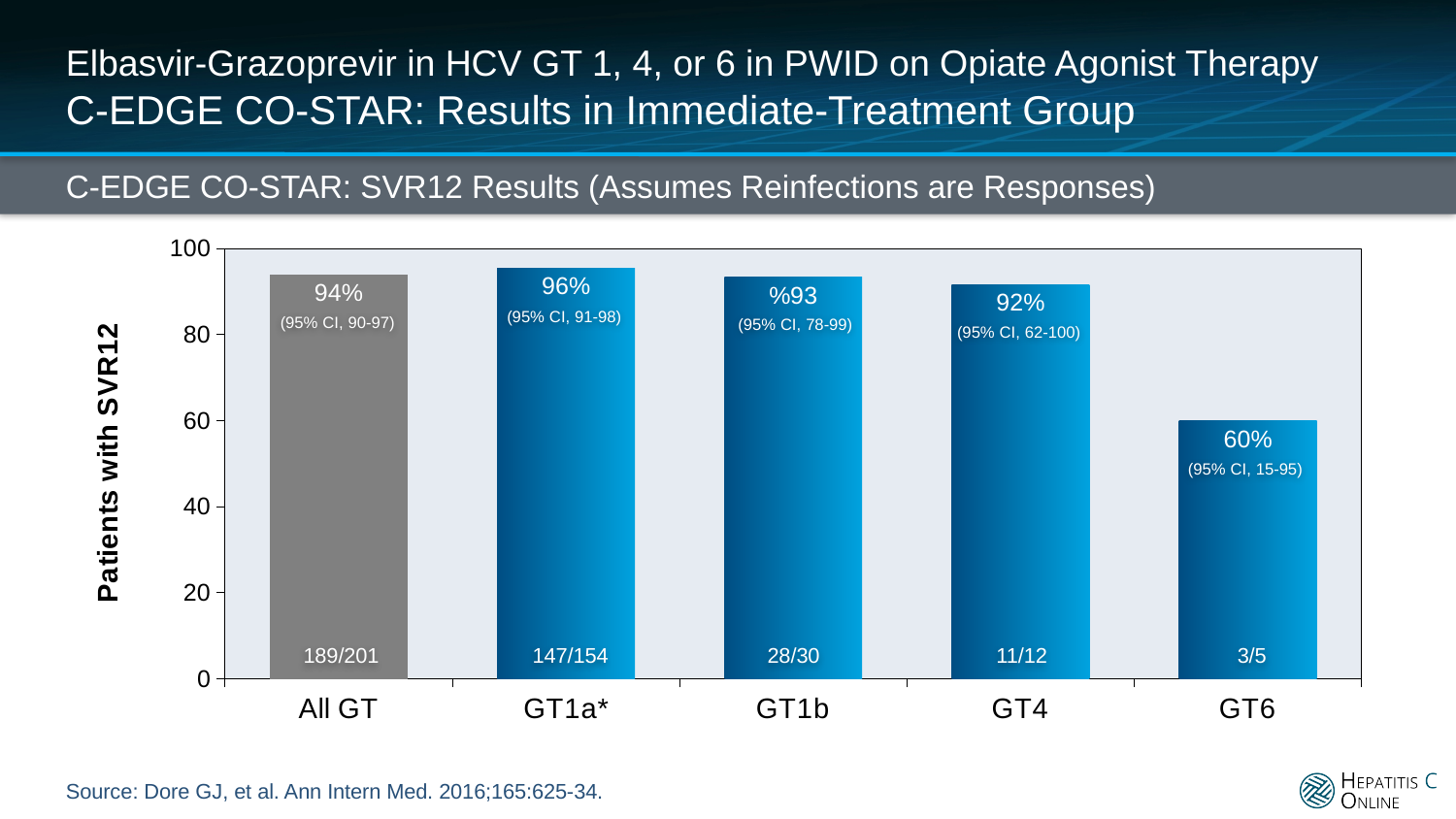
What is the SVR12 rate for GT1a*? 96% What fraction of patients achieved SVR12 in the GT1b group? 28/30 How many genotype groups are shown on the x axis? 5 What is the label of the y axis? Patients with SVR12 What kind of chart is shown on the slide? Bar chart What is the SVR12 rate for the All GT group? 94% Which has a higher SVR12 rate, GT4 or GT6? GT4 Which genotype group has the highest SVR12 rate? GT1a* What is the 95% confidence interval shown for GT4? 62-100 What is the SVR12 rate for GT6? 60% What is the difference in SVR12 rate between GT1a* and GT6? 36% Which genotype group has the lowest SVR12 rate? GT6